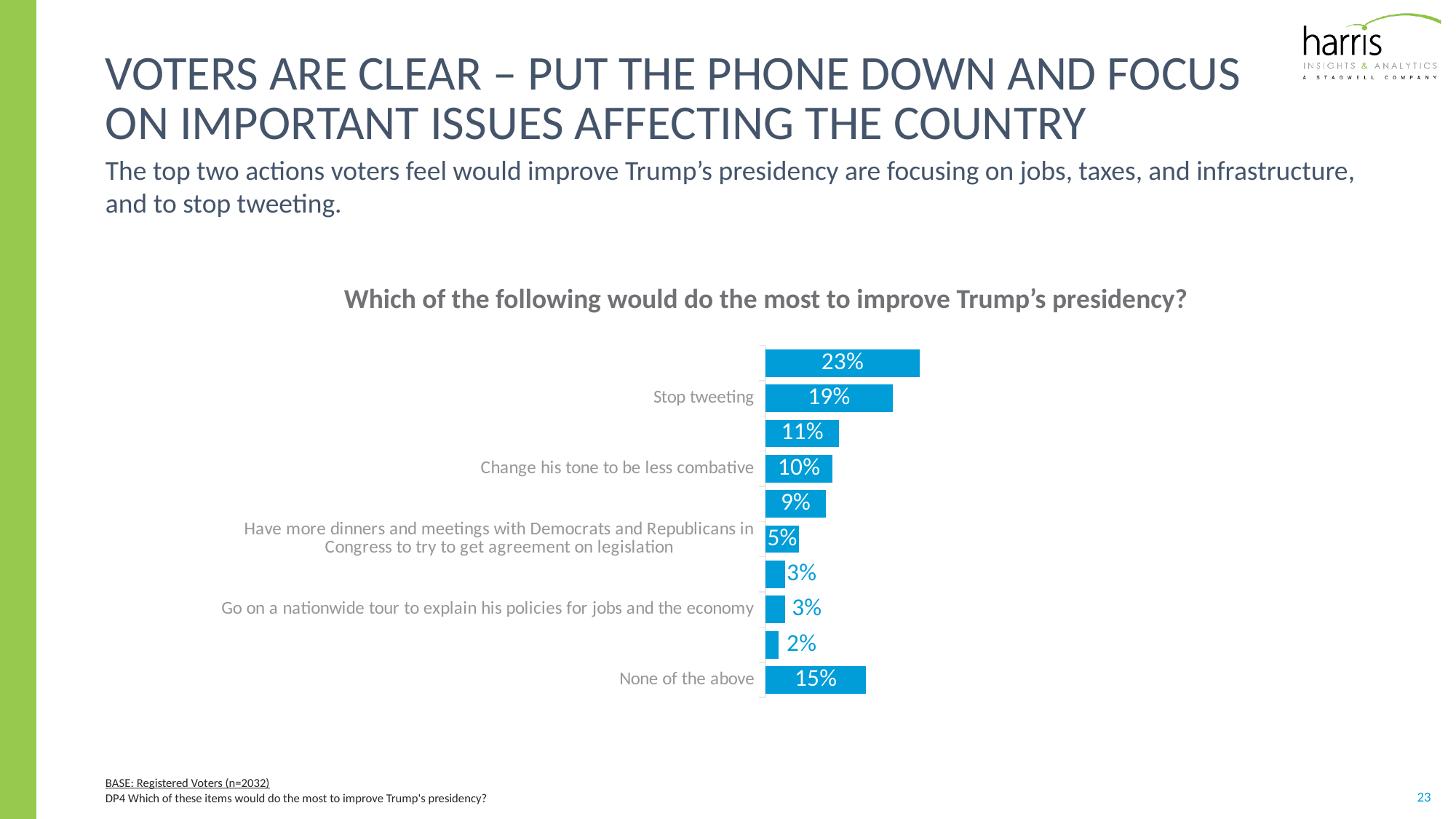
What percentage of voters chose "Stop tweeting"? 19% What is the difference between the value for "Stop tweeting" and the value for "Change his tone to be less combative"? 9 percentage points What is the smallest value shown on any bar in the chart? 2% What kind of chart is shown on the slide? bar chart What is the value for "Change his tone to be less combative"? 10% Which is larger, the value for "Stop tweeting" or the value for "None of the above"? Stop tweeting What is the value for "Have more dinners and meetings with Democrats and Republicans in Congress to try to get agreement on legislation"? 5% How many bars are plotted in the chart? 10 What is the largest value shown on any bar in the chart? 23% What is the value for "Go on a nationwide tour to explain his policies for jobs and the economy"? 3% What is the value for "None of the above"? 15% What is the title of the chart? Which of the following would do the most to improve Trump's presidency?